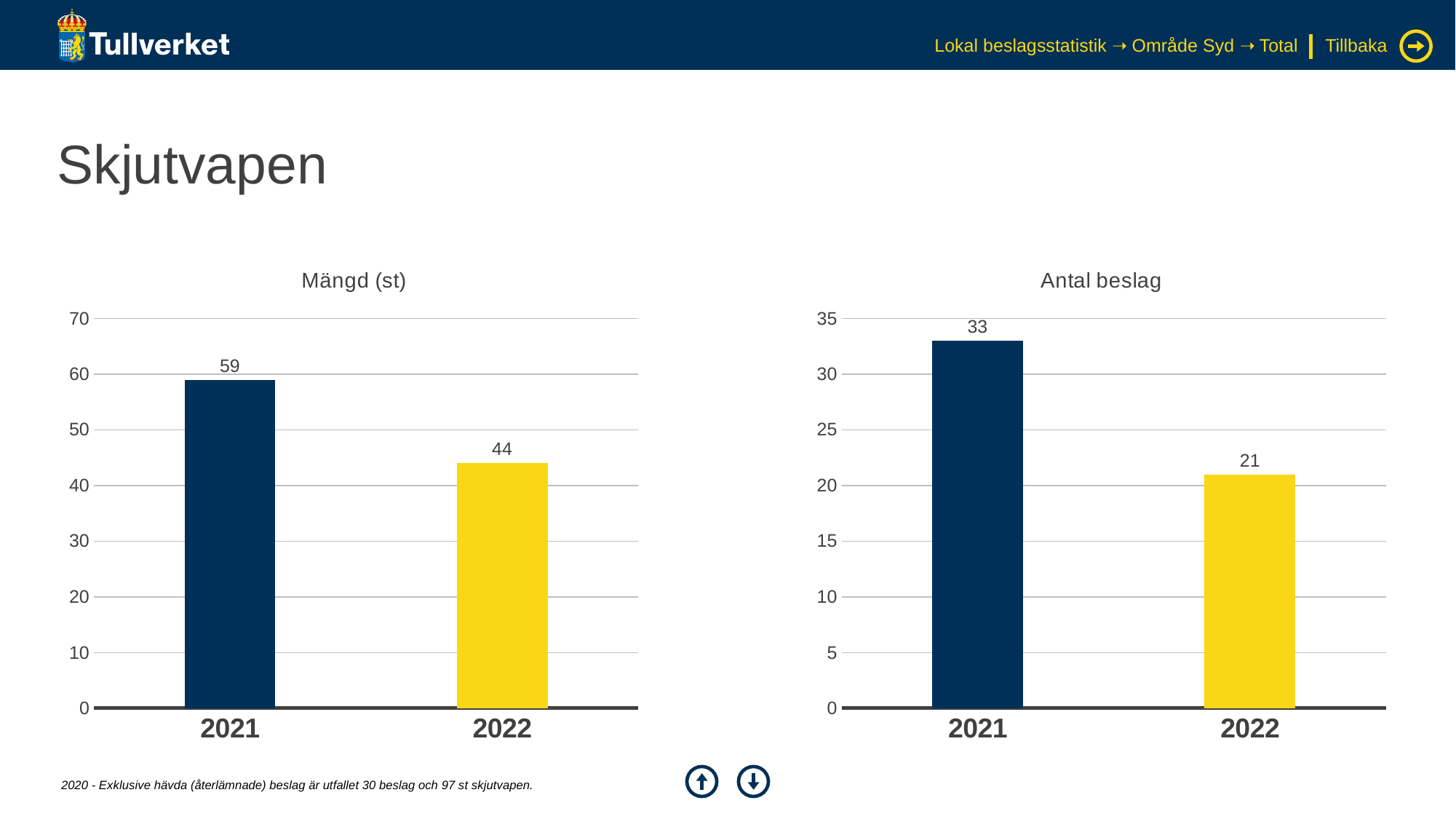
In the 'Mängd (st)' chart, which year has the highest value? 2021 In the 'Antal beslag' chart, what is the value for 2022? 21 In the 'Antal beslag' chart, what is the value for 2021? 33 In the 'Mängd (st)' chart, what is the value for 2022? 44 In the 'Mängd (st)' chart, what is the value for 2021? 59 In the 'Antal beslag' chart, is the value for 2021 greater or less than 30? greater In the 'Mängd (st)' chart, how many years are shown? 2 In the 'Antal beslag' chart, what is the difference between the 2021 and 2022 values? 12 In the 'Antal beslag' chart, which year has the lowest value? 2022 What kind of chart is the 'Antal beslag' chart? bar chart In the 'Mängd (st)' chart, do the values rise or fall from 2021 to 2022? fall In the 'Mängd (st)' chart, what is the difference between the 2021 and 2022 values? 15